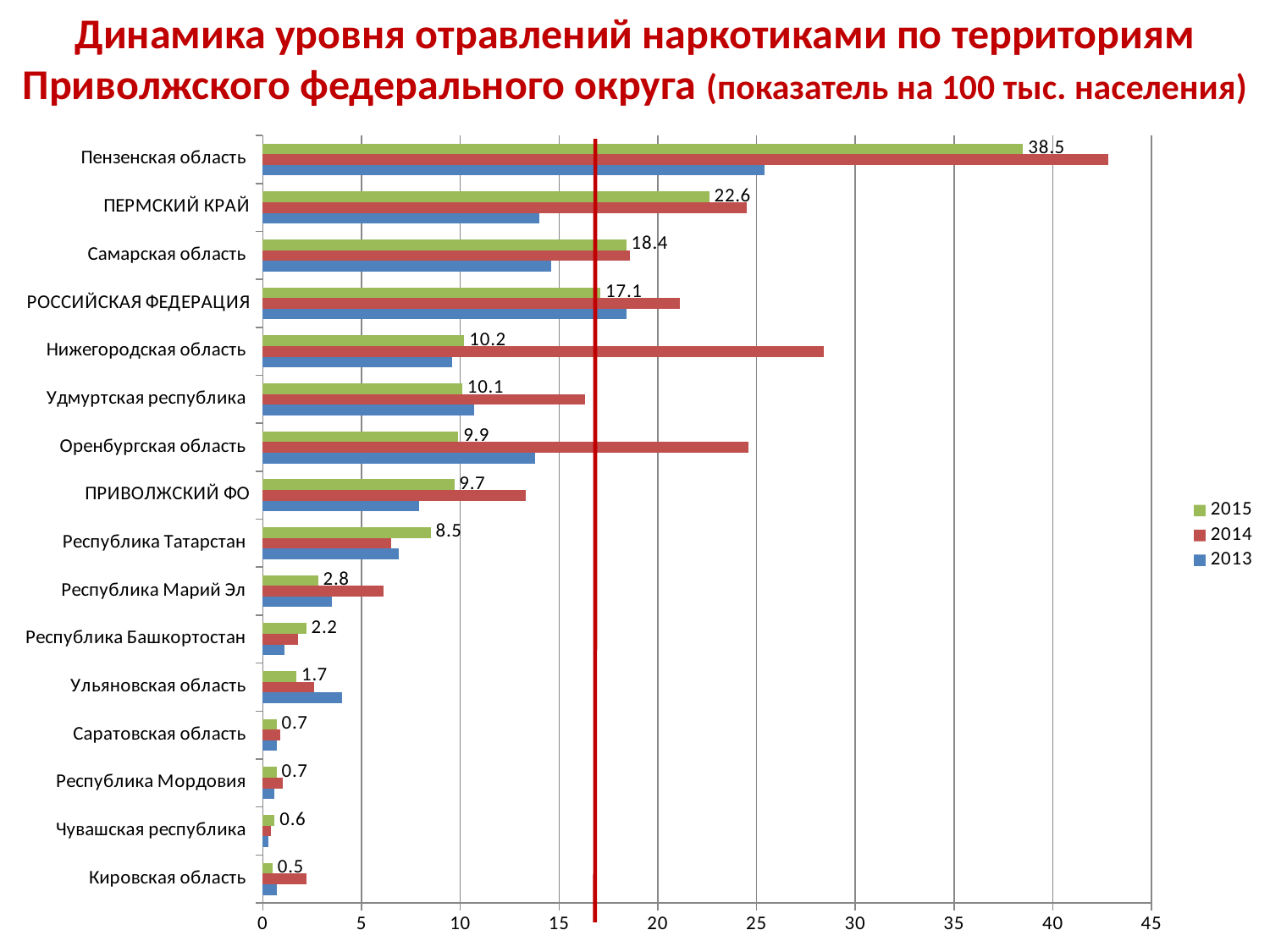
What is the 2015 value for РОССИЙСКАЯ ФЕДЕРАЦИЯ? 17.1 What kind of chart is shown on the slide? Bar chart Which has the larger 2015 value, Республика Татарстан or Республика Марий Эл? Республика Татарстан Which territory has the highest 2015 value? Пензенская область Is the 2014 value for Пензенская область greater or less than 40? greater How many territories are listed on the chart? 16 Is the 2014 value for Нижегородская область greater or less than 25? greater What is the 2015 value for ПРИВОЛЖСКИЙ ФО? 9.7 What is the 2015 value for Пензенская область? 38.5 How many series does the legend list? 3 Which territory has the lowest 2015 value? Кировская область What is the difference between the 2015 values for Пензенская область and ПЕРМСКИЙ КРАЙ? 15.9